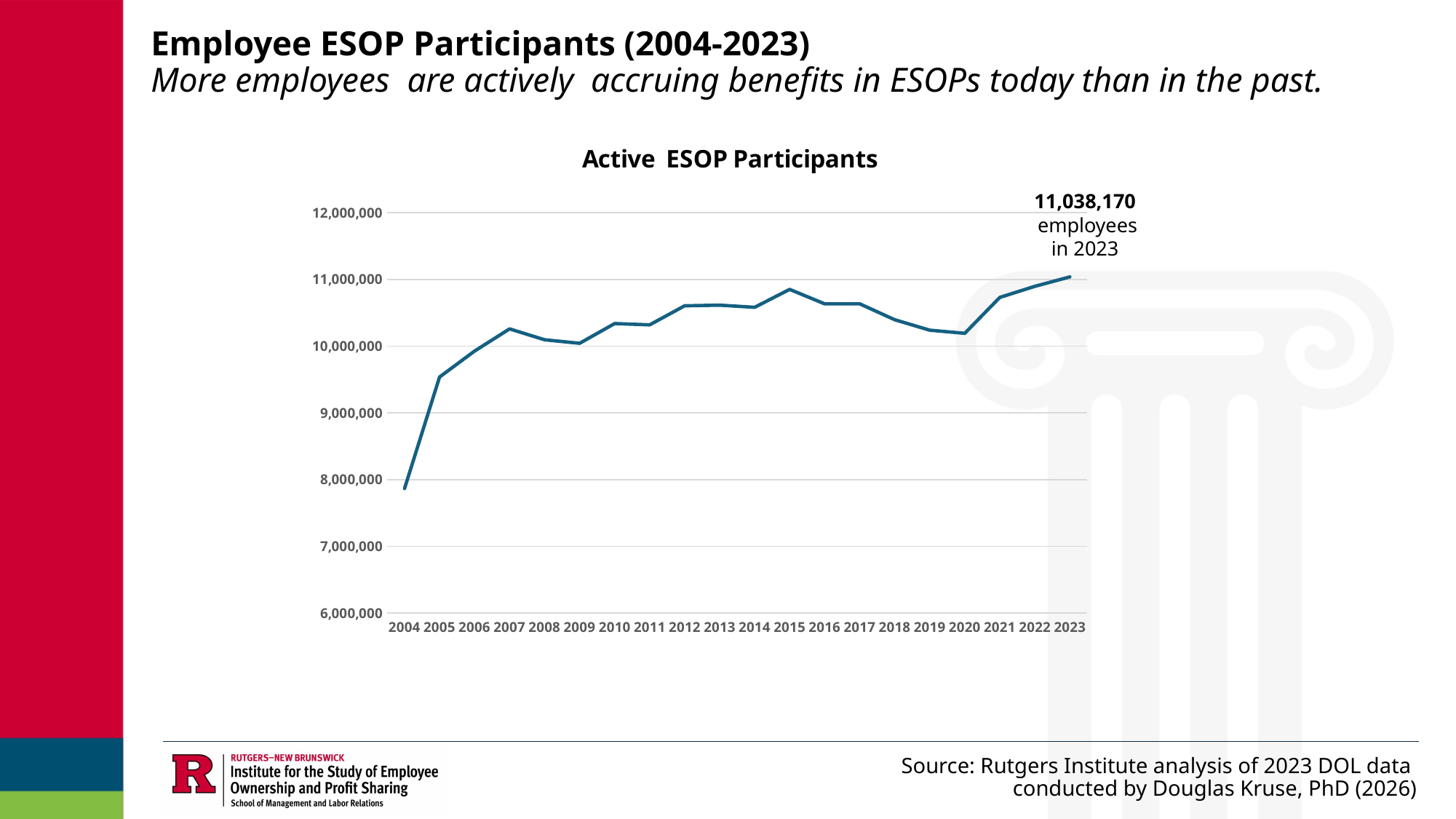
What is the number of active ESOP participants shown for 2023? 11,038,170 Which year has the highest number of active ESOP participants? 2023 What kind of chart is used to show Active ESOP Participants? line chart What is the title of the chart on the slide? Active ESOP Participants Which year has more active ESOP participants, 2004 or 2005? 2005 Which year has the lowest number of active ESOP participants? 2004 How many years are plotted on the x axis of the Active ESOP Participants chart? 20 Which year has more active ESOP participants, 2015 or 2020? 2015 Is the value for 2004 greater or less than 9,000,000? less Overall, do active ESOP participants rise or fall from 2004 to 2023? rise Is the value for 2015 greater or less than 10,000,000? greater Is the value for 2005 greater or less than 9,000,000? greater